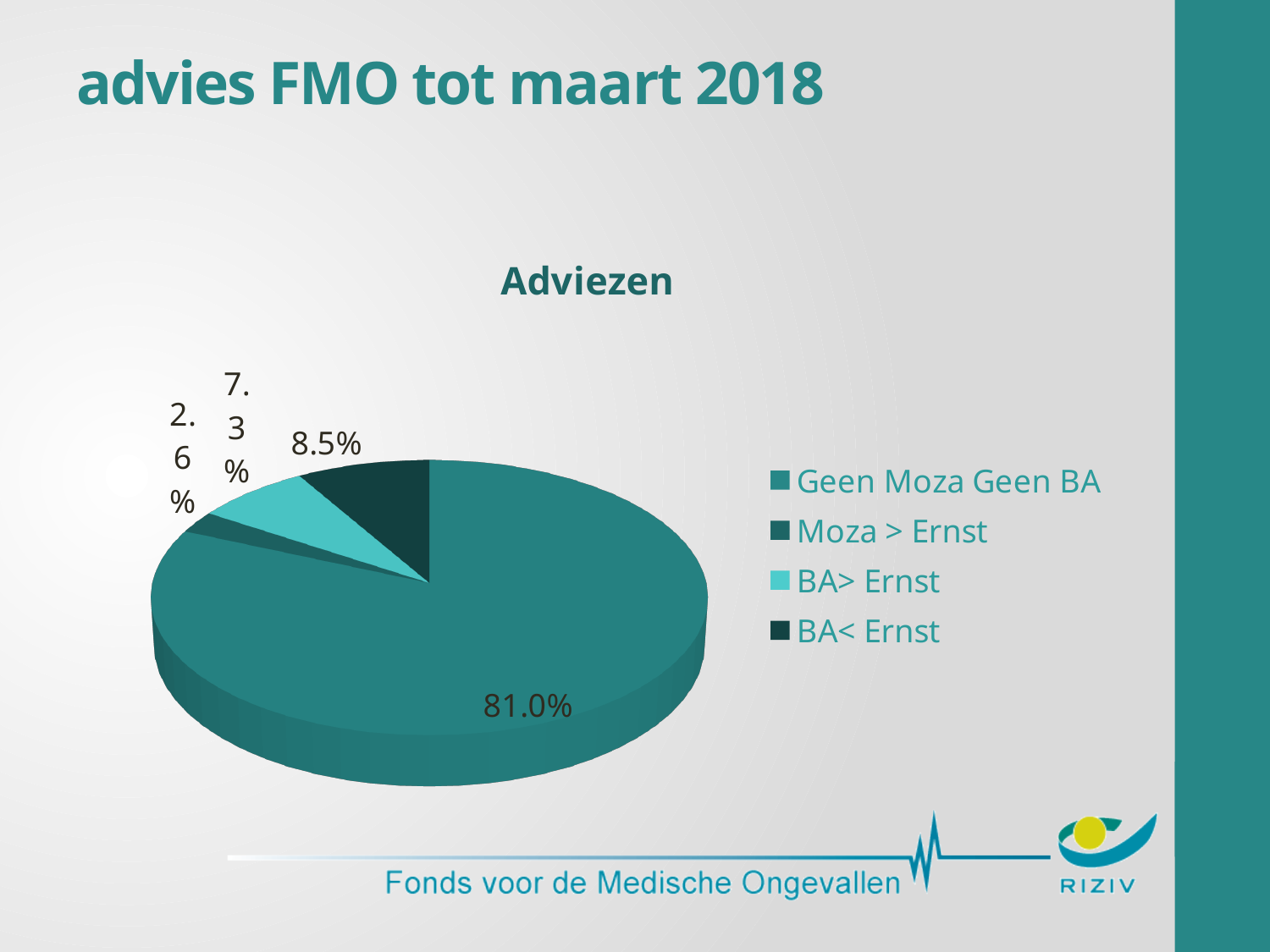
What percentage is shown for BA> Ernst? 7.3% Which category has the largest slice of the pie? Geen Moza Geen BA Which is larger, the share for Geen Moza Geen BA or the share for BA> Ernst? Geen Moza Geen BA Which legend entry is shown in the lightest (cyan) colour? BA> Ernst What is the difference in percentage points between Geen Moza Geen BA and BA> Ernst? 73.7 What is the largest percentage shown on the pie chart? 81.0% What share of the pie does Geen Moza Geen BA represent? 81.0% How many categories does the legend of the chart list? 4 How many slices does the pie chart have? 4 What is the title of the chart? Adviezen What type of chart is shown on the slide? Pie chart What is the smallest percentage shown on the pie chart? 2.6%